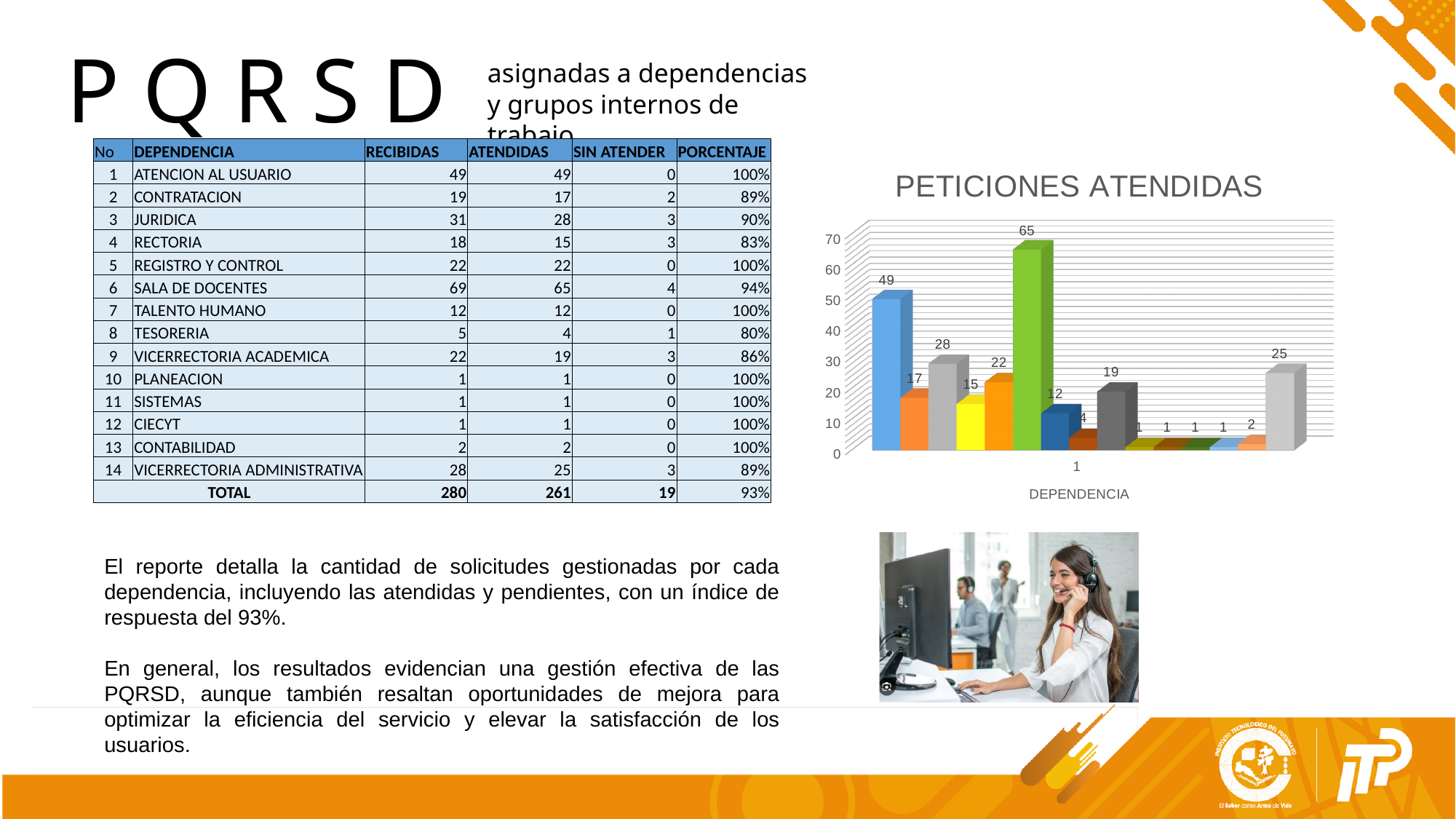
In the PETICIONES ATENDIDAS chart, which is larger: the bar labelled 28 or the bar labelled 22? 28 In the PETICIONES ATENDIDAS chart, what is the lowest value labelled on any bar? 1 In the PETICIONES ATENDIDAS chart, what value is labelled on the leftmost (blue) bar? 49 In the PETICIONES ATENDIDAS chart, what value is labelled on the rightmost bar? 25 In the PETICIONES ATENDIDAS chart, what is the difference between the tallest bar (65) and the leftmost bar (49)? 16 How many bars are plotted in the PETICIONES ATENDIDAS chart? 15 In the PETICIONES ATENDIDAS chart, is the value of the tallest green bar greater or less than 60? greater In the PETICIONES ATENDIDAS chart, what value is labelled on the tallest (green) bar? 65 In the PETICIONES ATENDIDAS chart, what is the highest value labelled on any bar? 65 What is the title of the chart on the right side of the slide? PETICIONES ATENDIDAS What is the label shown on the horizontal axis of the PETICIONES ATENDIDAS chart? DEPENDENCIA What kind of chart is shown under the title PETICIONES ATENDIDAS? bar chart